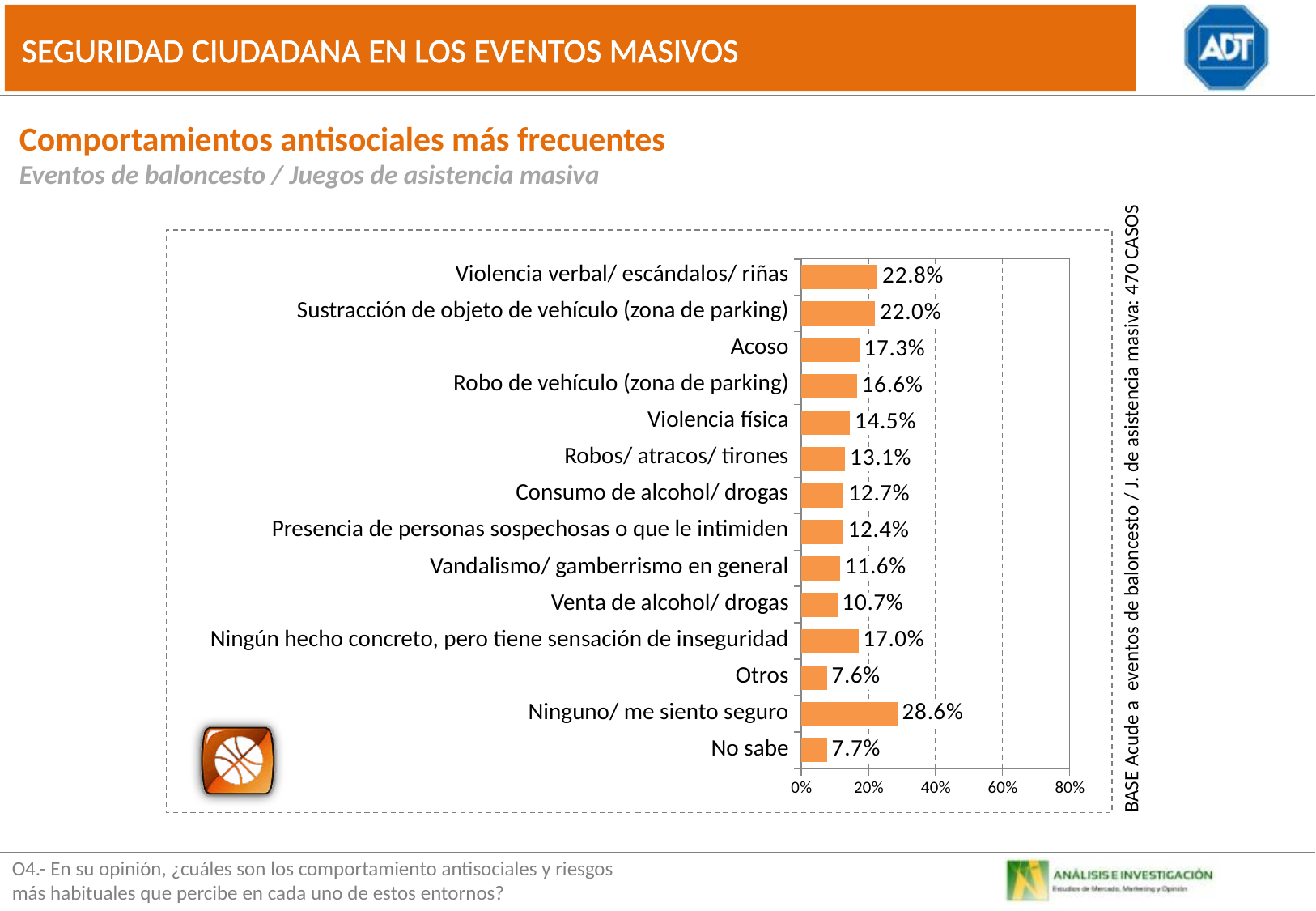
What is the base (number of cases) stated next to the chart? 470 CASOS How many categories are shown in the chart? 14 What is the value for "Acoso"? 17.3% Which category has the lowest value? Otros What kind of chart is shown on the slide? bar chart What is the value for "Ninguno/ me siento seguro"? 28.6% Is the value for "Ninguno/ me siento seguro" greater or less than 20%? greater Which category has the highest value? Ninguno/ me siento seguro What is the difference between "Violencia verbal/ escándalos/ riñas" and "Sustracción de objeto de vehículo (zona de parking)"? 0.8% What is the value for "Violencia verbal/ escándalos/ riñas"? 22.8% Which is larger, "Violencia física" or "Robos/ atracos/ tirones"? Violencia física What is the value for "Venta de alcohol/ drogas"? 10.7%